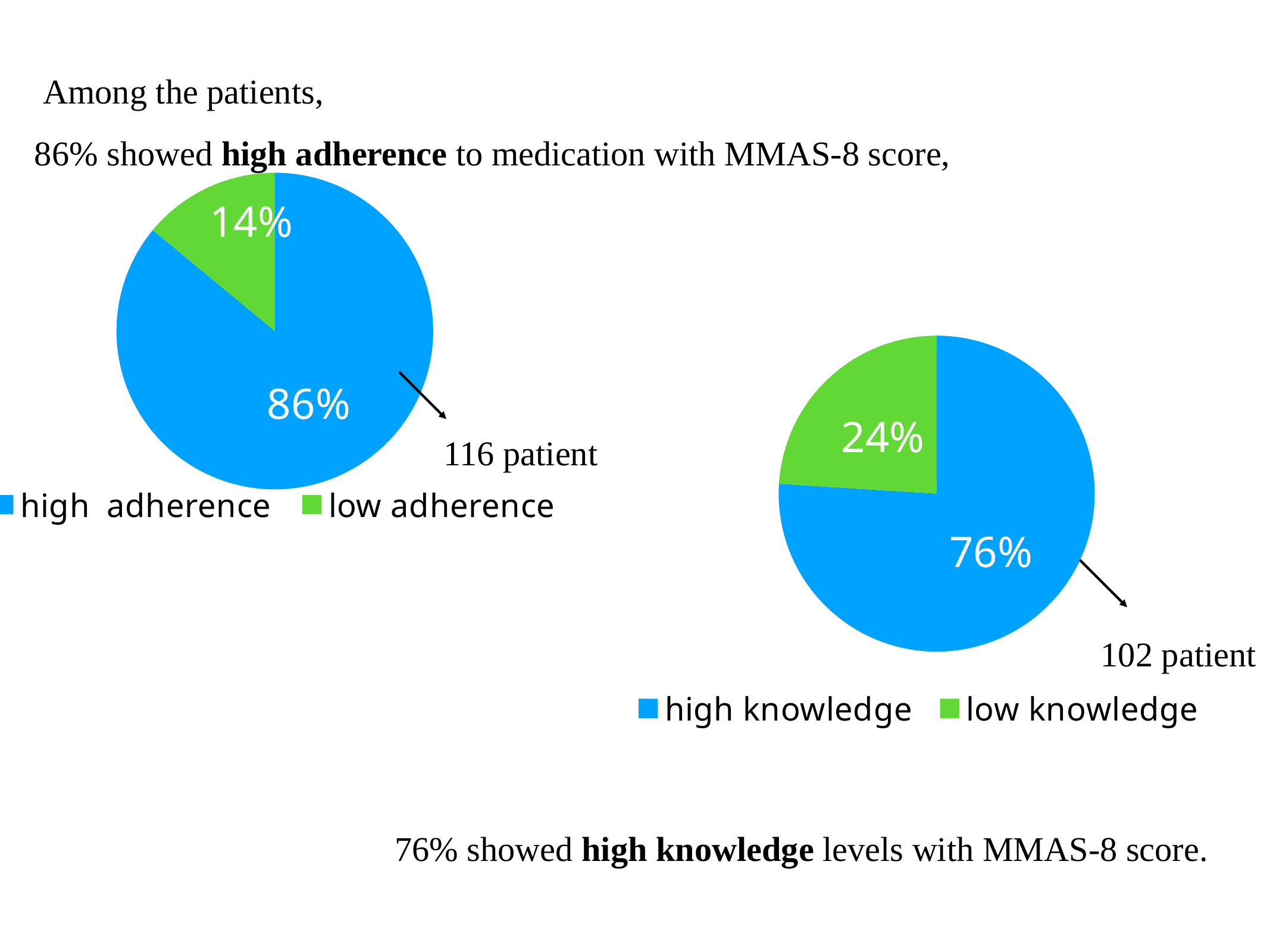
In the right pie chart (knowledge), what percentage of patients showed low knowledge? 24% Which is larger: the low adherence slice in the left pie chart or the low knowledge slice in the right pie chart? low knowledge How many slices does the right pie chart (knowledge) have? 2 In the right pie chart (knowledge), which slice is the smallest? low knowledge In the right pie chart (knowledge), what colour is the high knowledge slice? blue In the left pie chart (adherence), which slice is the largest? high adherence In the left pie chart (adherence), what percentage of patients showed low adherence? 14% In the left pie chart (adherence), what is the difference in percentage points between the high adherence and low adherence slices? 72 In the right pie chart (knowledge), what percentage of patients showed high knowledge? 76% In the right pie chart (knowledge), what is the difference in percentage points between the high knowledge and low knowledge slices? 52 In the left pie chart (adherence), what percentage of patients showed high adherence? 86% What type of chart is used on the left side of the slide? pie chart